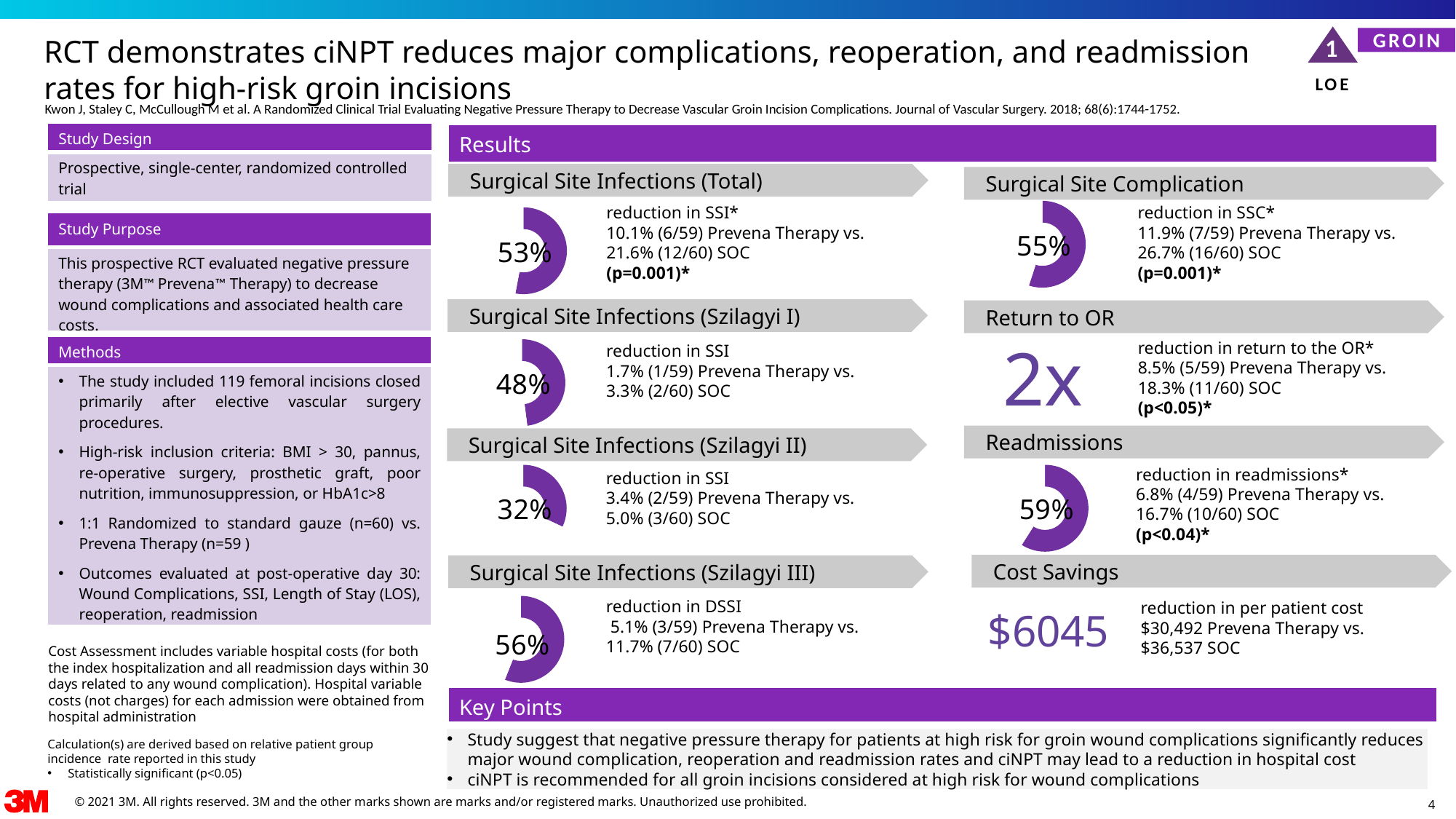
In the Surgical Site Complication chart, what percentage reduction in SSC is shown? 55% How many percentage ring charts are shown in the Results section of the slide? 6 What kind of chart is used to display the percentage reductions in the Results section? Donut (ring) chart In the Surgical Site Infections (Total) chart, what percentage reduction in SSI is shown? 53% Among the percentage ring charts on the slide, which outcome shows the largest percentage reduction? Readmissions (59%) In the Surgical Site Infections (Szilagyi III) chart, what percentage reduction in DSSI is shown? 56% In the Readmissions chart, what percentage reduction in readmissions is shown? 59% In the Surgical Site Infections (Szilagyi II) chart, what percentage reduction is shown? 32% In the Surgical Site Infections (Szilagyi I) chart, what percentage reduction is shown? 48% Which shows a larger percentage reduction: the Surgical Site Infections (Total) chart or the Surgical Site Complication chart? Surgical Site Complication (55%) What is the difference in percentage points between the Szilagyi III reduction and the Szilagyi II reduction? 24 percentage points Among the percentage ring charts on the slide, which outcome shows the smallest percentage reduction? Surgical Site Infections (Szilagyi II) (32%)